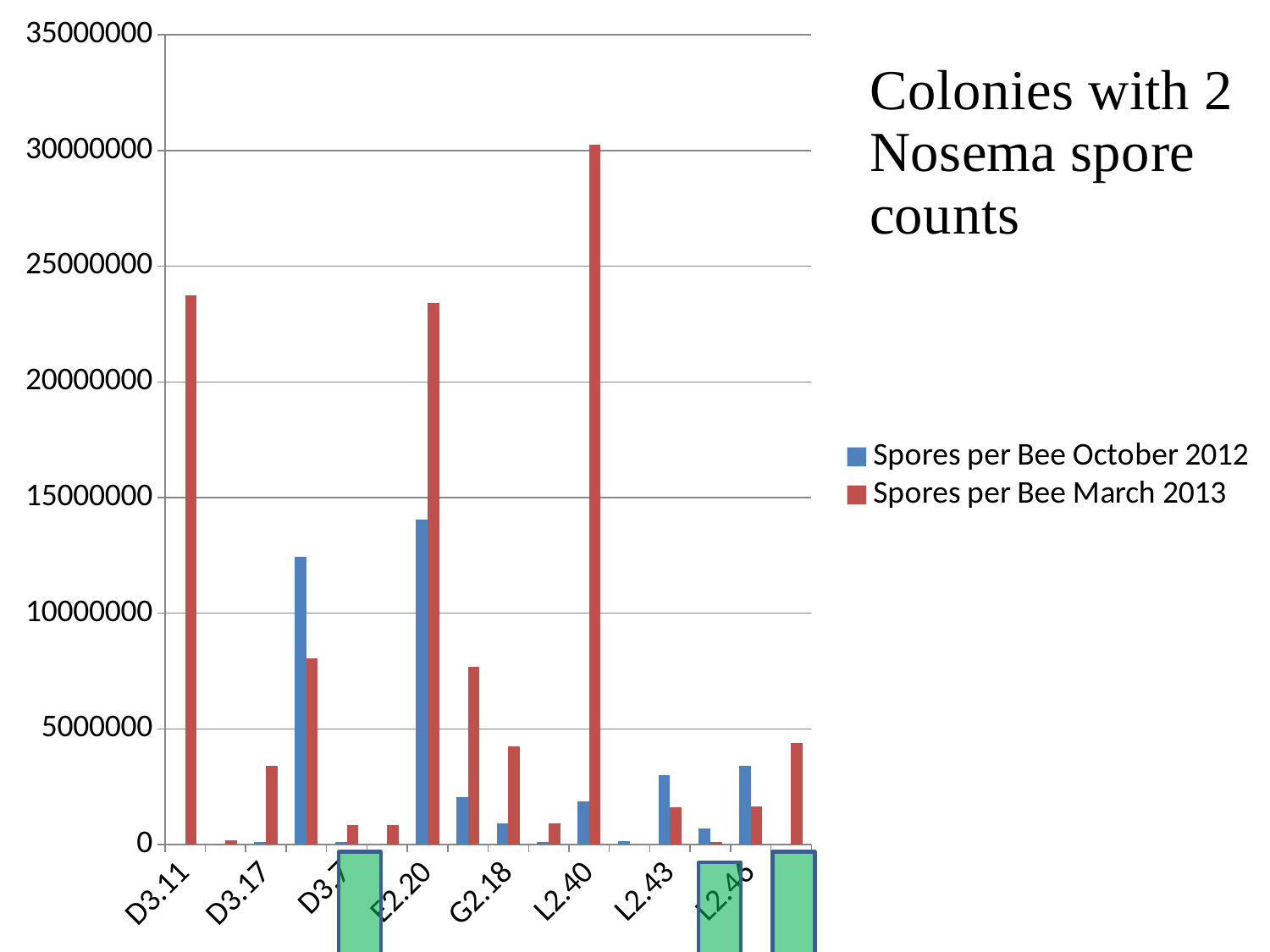
For L2.43, which is larger: Spores per Bee October 2012 or Spores per Bee March 2013? Spores per Bee October 2012 What is the title shown next to the chart? Colonies with 2 Nosema spore counts For E2.20, which is larger: Spores per Bee October 2012 or Spores per Bee March 2013? Spores per Bee March 2013 Is the Spores per Bee March 2013 value for G2.18 greater or less than 5000000? less How many series does the legend list? 2 Is the Spores per Bee March 2013 value for D3.11 greater or less than 20000000? greater Which colony has the highest Spores per Bee March 2013 value? L2.40 What are the two series named in the legend? Spores per Bee October 2012 and Spores per Bee March 2013 Is the Spores per Bee March 2013 value for L2.40 greater or less than 25000000? greater What kind of chart is shown on the slide? bar chart Which has the larger Spores per Bee March 2013 value: D3.11 or L2.40? L2.40